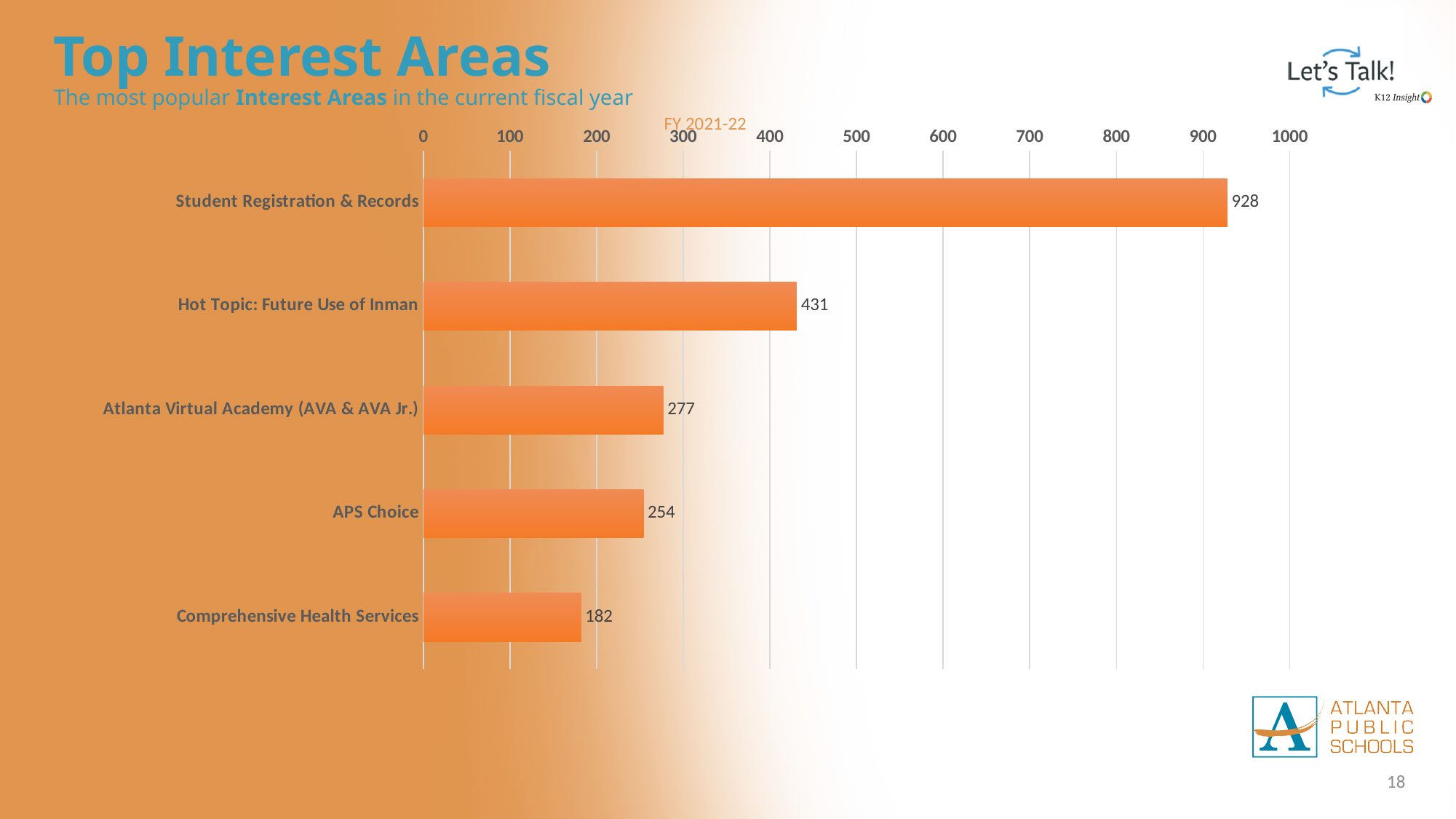
What is the value for Student Registration & Records? 928 Which is larger, the value for APS Choice or the value for Comprehensive Health Services? APS Choice Which interest area has the lowest value? Comprehensive Health Services How many interest areas are shown in the chart? 5 What is the value for Hot Topic: Future Use of Inman? 431 What kind of chart is shown on the slide? bar chart What is the difference between the values for Student Registration & Records and Hot Topic: Future Use of Inman? 497 Is the value for APS Choice greater or less than 300? less What fiscal year label is shown above the chart? FY 2021-22 What is the value for Atlanta Virtual Academy (AVA & AVA Jr.)? 277 Which interest area has the highest value? Student Registration & Records What is the value for Comprehensive Health Services? 182